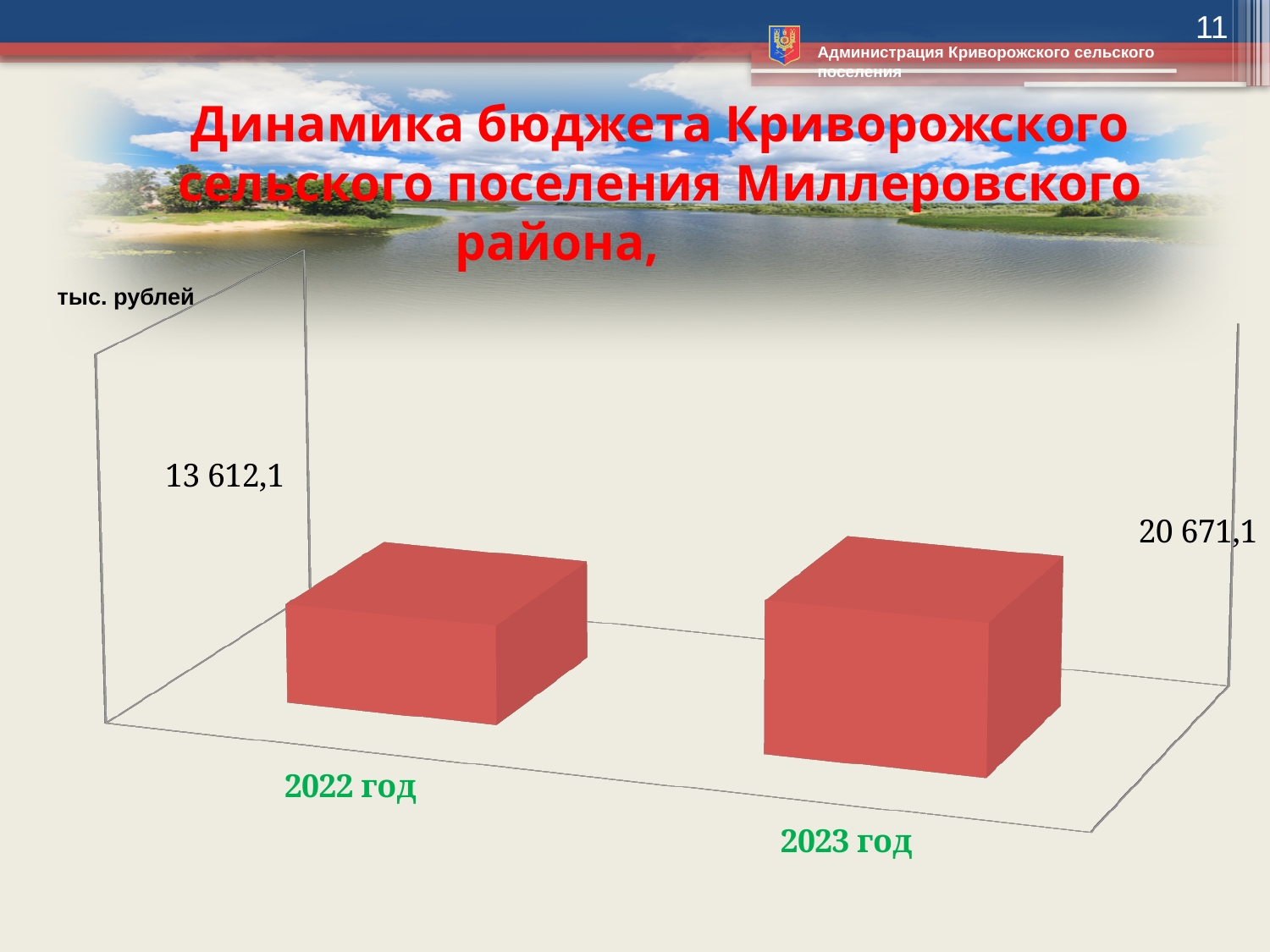
Which year has the lowest value? 2022 год What is the value for 2022 год? 13 612,1 Which is larger, the value for 2022 год or the value for 2023 год? 2023 год What is the value for 2023 год? 20 671,1 What kind of chart is shown on the slide? Bar chart What colour are the bars in the chart? Red How many categories are shown in the chart? 2 Do the values rise or fall from 2022 год to 2023 год? Rise Which year has the highest value? 2023 год What is the difference between the values for 2023 год and 2022 год? 7 059,0 In what units are the chart values given? тыс. рублей